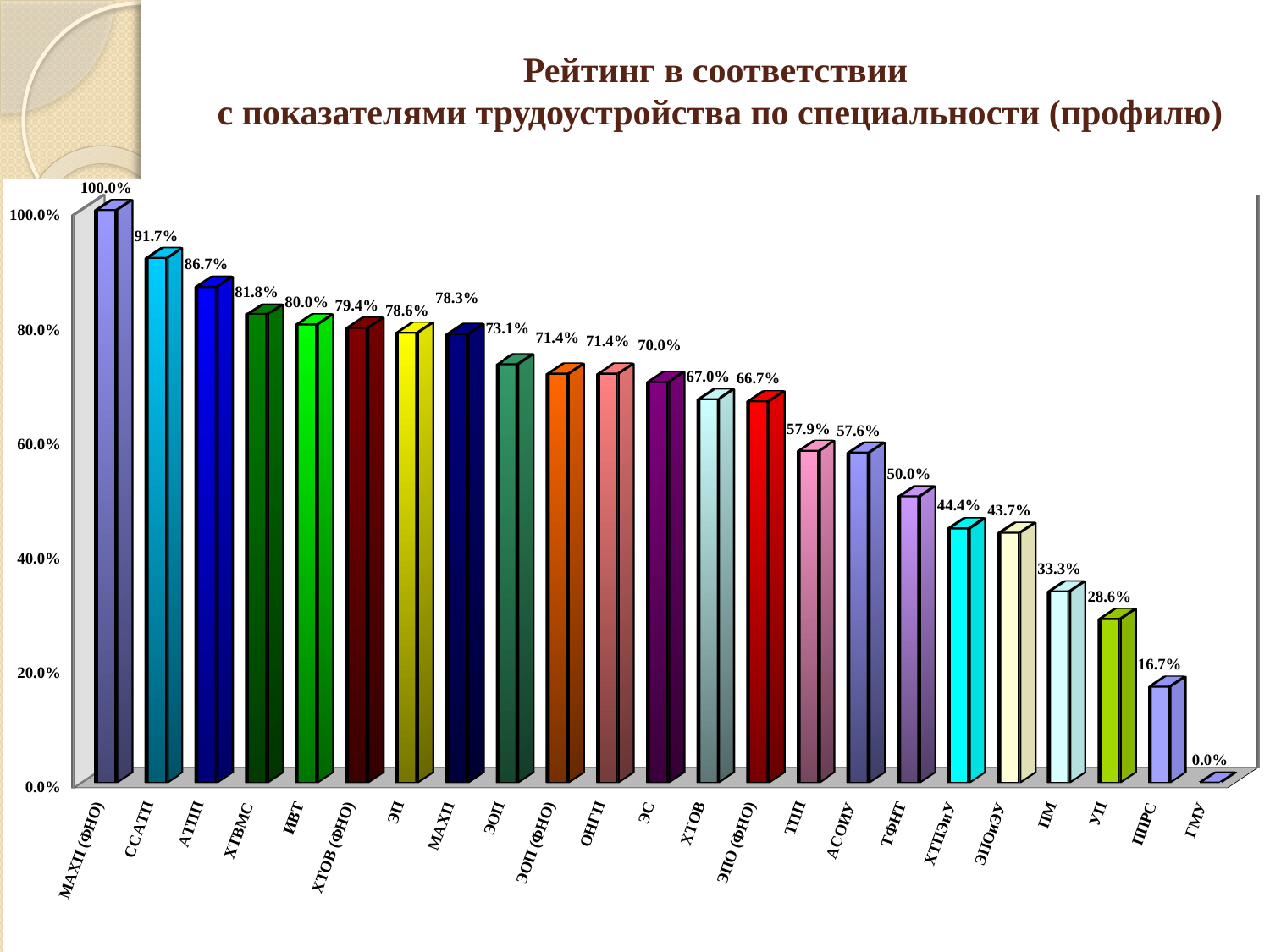
Which category has the lowest value? ГМУ Which is larger, the value for ЭС or the value for ХТОВ? ЭС How many categories are plotted in the chart? 23 What type of chart is shown on the slide? bar chart Which category has the highest value? МАХП (ФНО) Do the values rise or fall from left to right along the x axis? fall What is the difference between the values for АТПП and ХТВМС? 4.9% What is the value for ИВТ? 80.0% What is the value for ППРС? 16.7% What is the value for ТФНТ? 50.0% What is the value for ССАТП? 91.7% What is the difference between the values for ПМ and УП? 4.7%